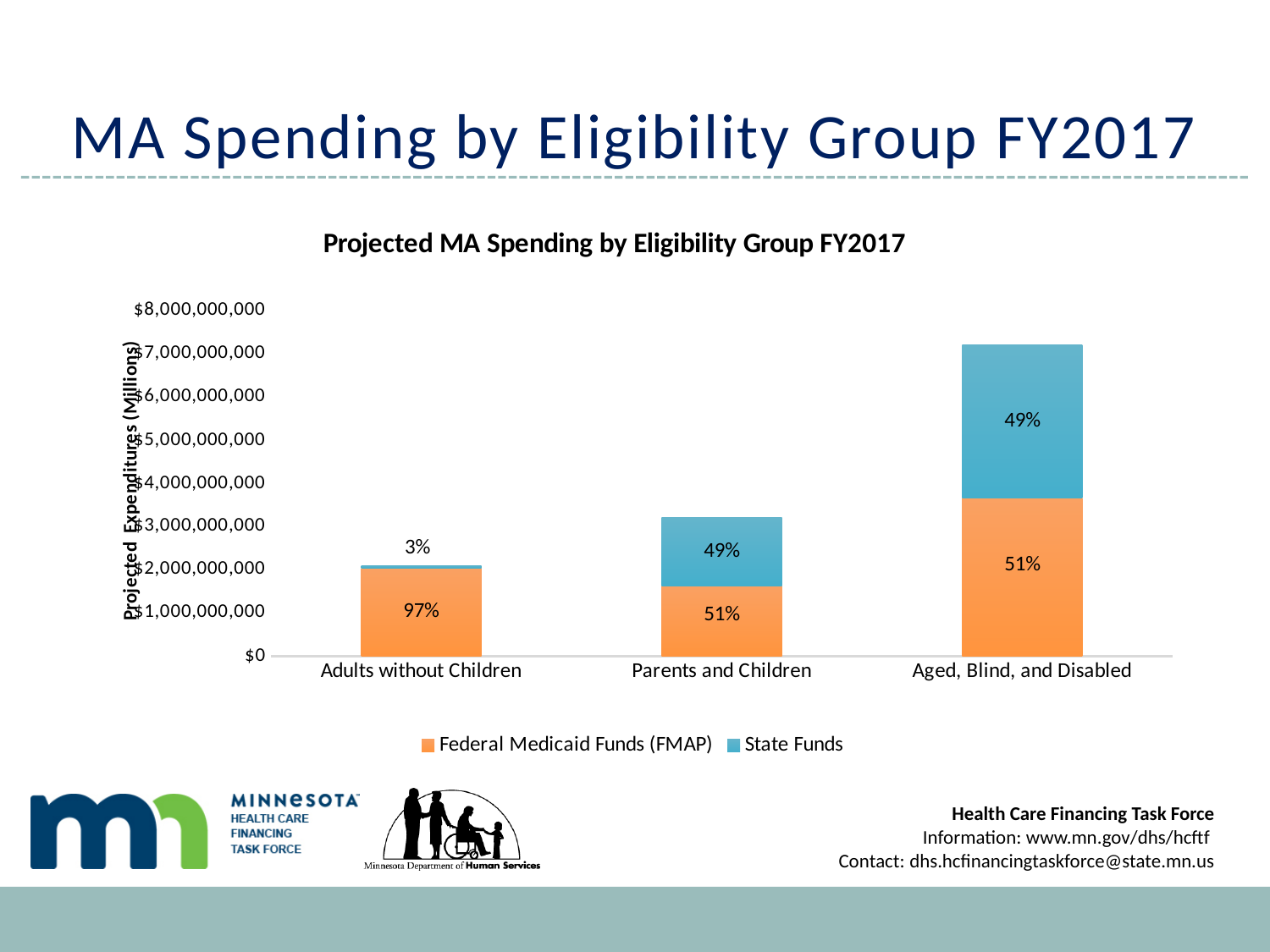
Do the total bar heights rise or fall from left to right across the eligibility groups? Rise Is the total projected spending for Parents and Children greater or less than $3,000,000,000? greater What kind of chart is shown on the slide? Stacked bar chart What percentage of spending for Adults without Children comes from State Funds? 3% What percentage of spending for Adults without Children comes from Federal Medicaid Funds (FMAP)? 97% Which eligibility group has the lowest projected MA spending? Adults without Children How many eligibility groups are shown on the x axis? 3 Is the total projected spending for Aged, Blind, and Disabled greater or less than $7,000,000,000? greater Which eligibility group has the highest projected MA spending? Aged, Blind, and Disabled What percentage of spending for Aged, Blind, and Disabled comes from Federal Medicaid Funds (FMAP)? 51% What percentage of spending for Parents and Children comes from State Funds? 49% How many series does the legend list? 2